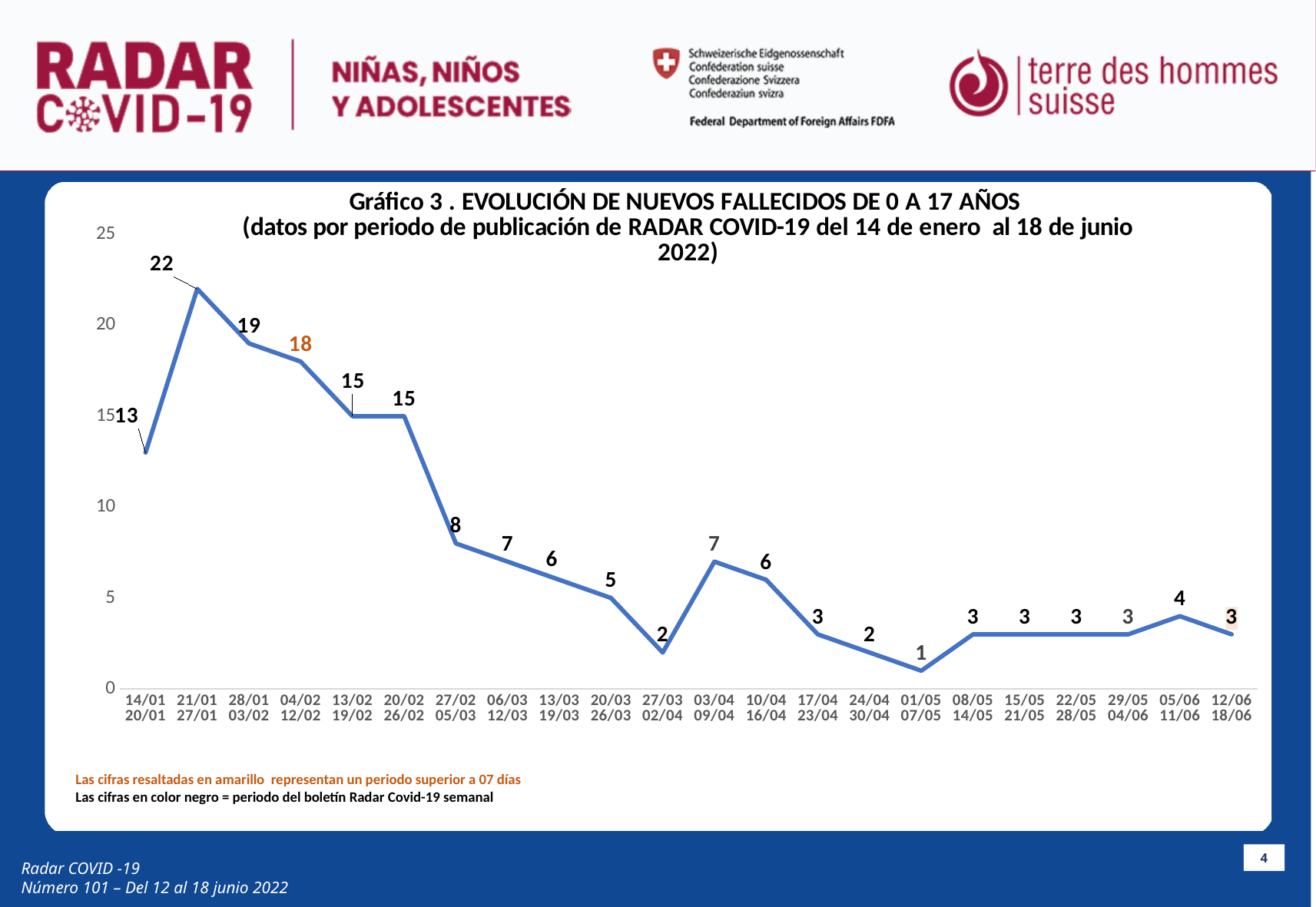
What is the value for the period 01/05–07/05? 1 According to the note below the chart, what do the figures highlighted in colour represent? A period longer than 07 days What is the value for the period 21/01–27/01? 22 What type of chart is shown on the slide? Line chart Which period has the lowest value? 01/05–07/05 Overall, do the values rise or fall from the period 21/01–27/01 to the period 01/05–07/05? Fall What is the difference between the values for 21/01–27/01 and 14/01–20/01? 9 Which is larger, the value for 03/04–09/04 or the value for 27/03–02/04? 03/04–09/04 What is the value for the last period, 12/06–18/06? 3 Which period has the highest value? 21/01–27/01 What is the value for the period 04/02–12/02? 18 How many periods (data points) are plotted on the chart? 22